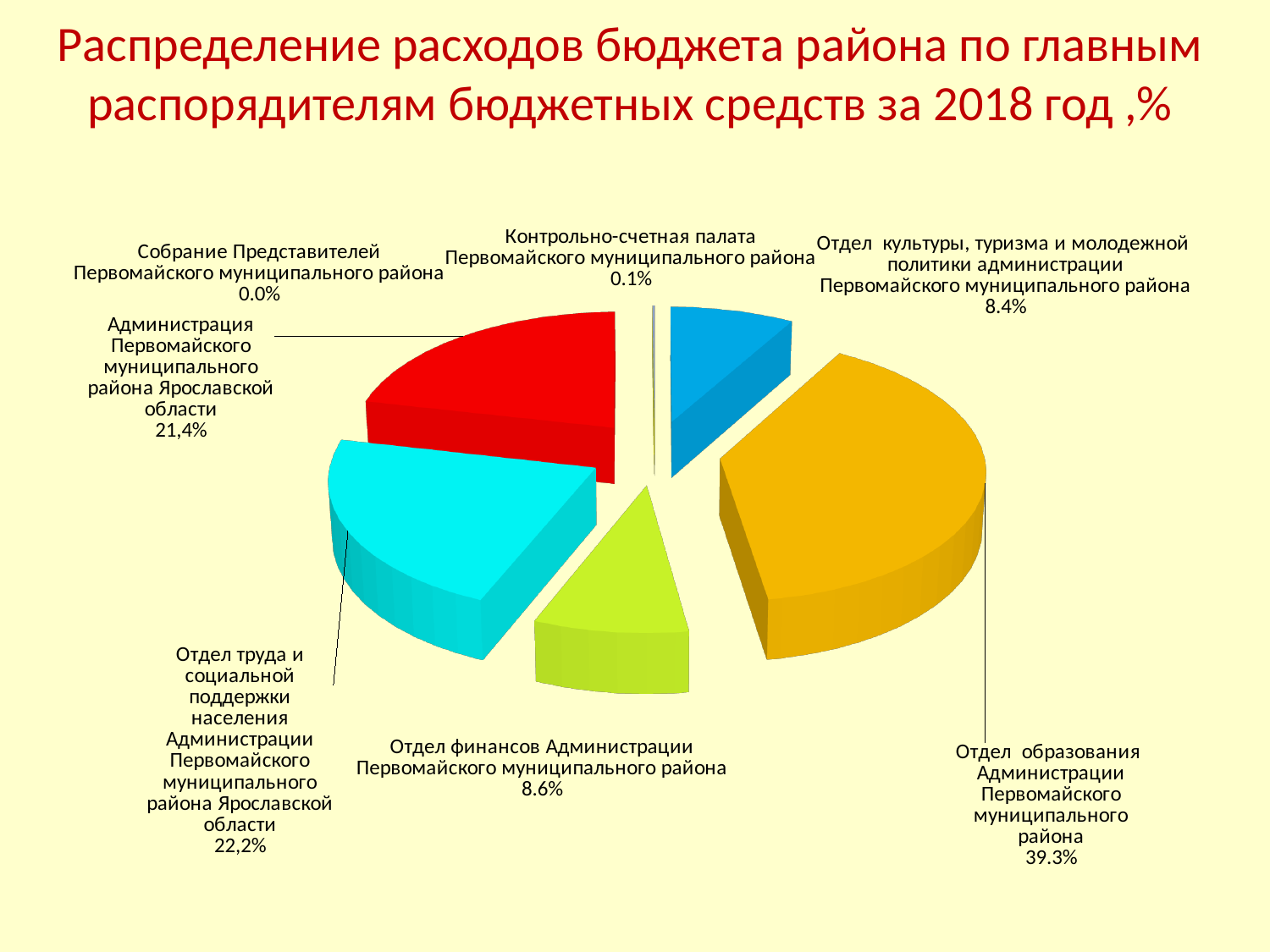
What type of chart is shown on the slide? Pie chart Which is larger: the share for Отдел финансов or the share for Отдел культуры, туризма и молодежной политики? Отдел финансов Which category has the largest share of the budget expenditures? Отдел образования Администрации Первомайского муниципального района What is the value for Администрация Первомайского муниципального района Ярославской области? 21,4% How many categories (slices) does the pie chart show? 7 What share of the district budget expenditures goes to Отдел образования Администрации Первомайского муниципального района? 39.3% What is the title of the chart on the slide? Распределение расходов бюджета района по главным распорядителям бюджетных средств за 2018 год ,% What is the value for Контрольно-счетная палата Первомайского муниципального района? 0.1% What is the value for Отдел финансов Администрации Первомайского муниципального района? 8.6% Which is larger: the share for Отдел труда и социальной поддержки населения or the share for Администрация Первомайского муниципального района Ярославской области? Отдел труда и социальной поддержки населения What is the difference between the share for Отдел образования (39.3%) and the share for Отдел финансов (8.6%)? 30.7% Which category has the smallest share of the budget expenditures? Собрание Представителей Первомайского муниципального района